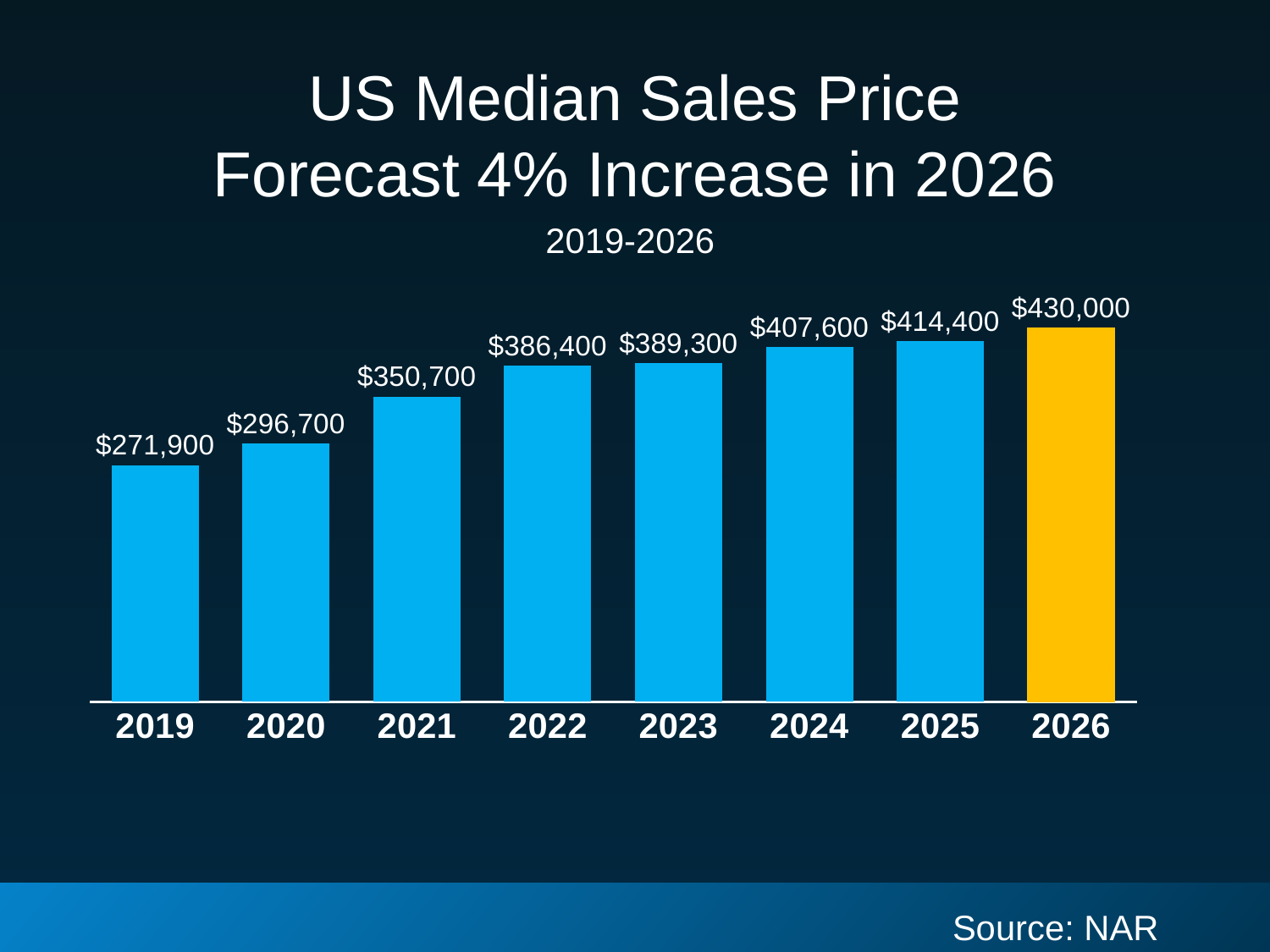
Which year has a higher median sales price, 2023 or 2024? 2024 What is the difference between the median sales price in 2026 and in 2025? $15,600 What is the US median sales price shown for 2022? $386,400 What is the US median sales price shown for 2019? $271,900 How many years are shown on the chart? 8 What kind of chart is shown on the slide? Bar chart What is the forecast US median sales price for 2026? $430,000 Which year has the highest median sales price on the chart? 2026 Which year's bar is coloured differently (yellow) from the others? 2026 Do the median sales prices rise or fall from 2019 to 2026? Rise What is the difference between the median sales price in 2021 and in 2020? $54,000 Which year has the lowest median sales price on the chart? 2019